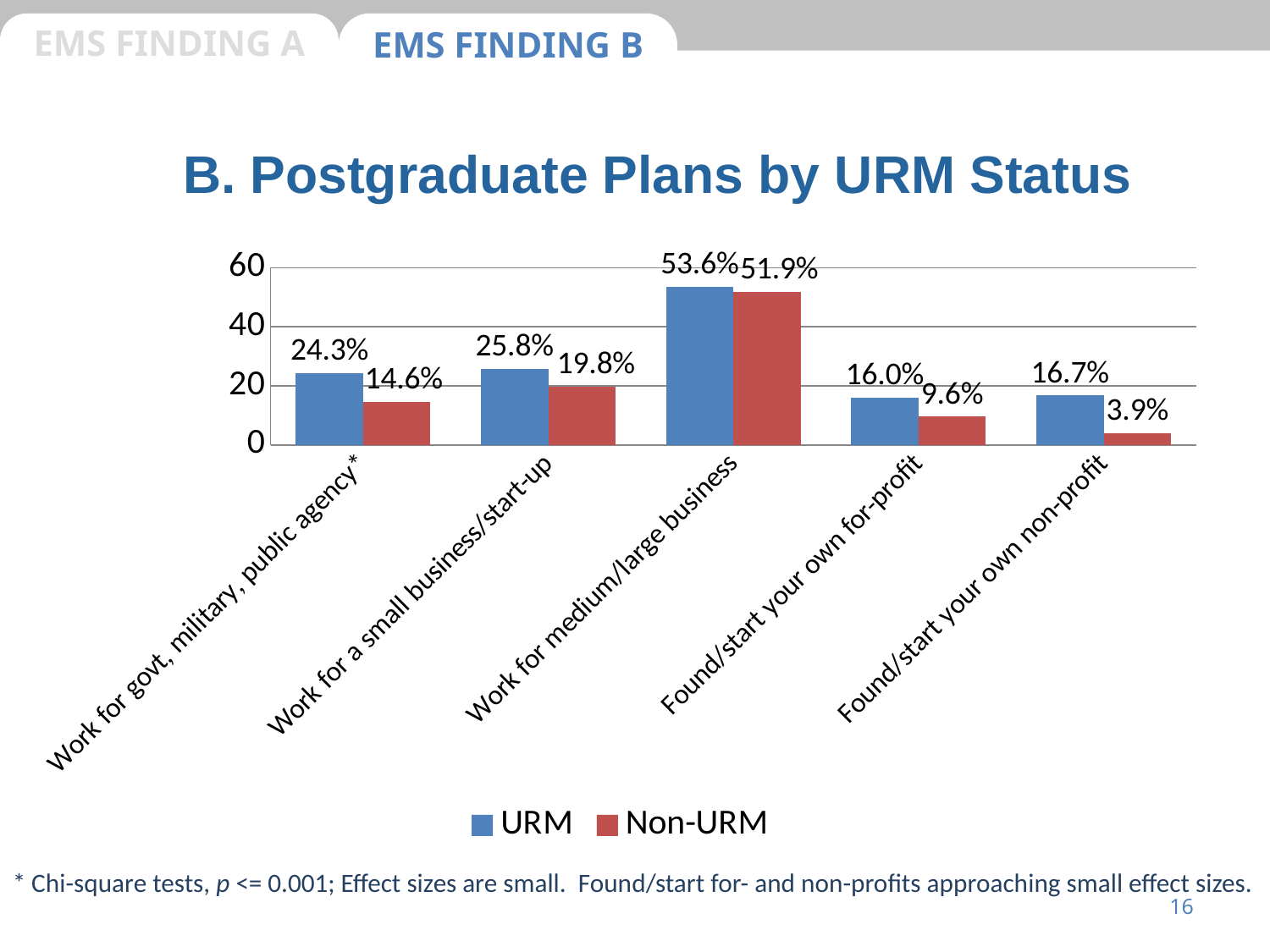
How many series does the legend list? 2 What is the Non-URM value for "Found/start your own non-profit"? 3.9% Is the Non-URM value for "Work for medium/large business" greater or less than 40? greater Which is larger for "Found/start your own for-profit": the URM value or the Non-URM value? URM Which category has the highest URM value? Work for medium/large business Which category has the lowest Non-URM value? Found/start your own non-profit How many categories are shown on the x axis? 5 What is the URM value for "Work for medium/large business"? 53.6% What is the Non-URM value for "Work for a small business/start-up"? 19.8% What kind of chart is shown on the slide? Bar chart What is the title of the chart? B. Postgraduate Plans by URM Status What is the difference between the URM and Non-URM values for "Work for govt, military, public agency*"? 9.7%